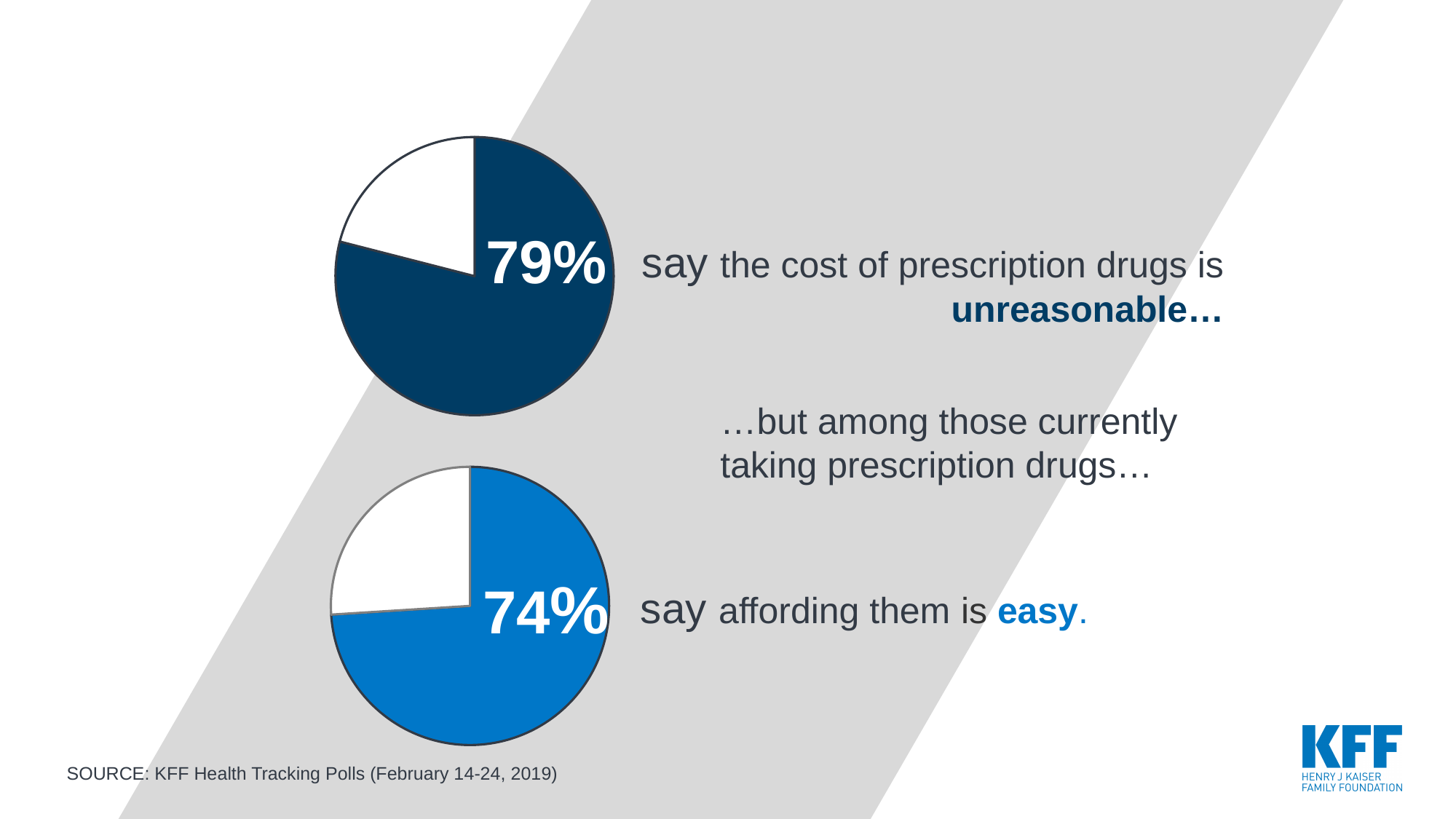
On the bottom pie chart, what share of the pie does the blue slice represent? 74% What colour is the labelled slice on the bottom pie chart? Light blue What source is cited for the data on the slide? KFF Health Tracking Polls (February 14-24, 2019) On the top pie chart, what share of the pie does the dark blue slice represent? 79% Which is larger: the labelled share on the top pie chart or the labelled share on the bottom pie chart? The top pie chart (79%) How many pie charts are shown on the slide? 2 What is the difference in percentage points between the 79% on the top pie chart and the 74% on the bottom pie chart? 5 percentage points On the top pie chart, which slice is larger: the dark blue slice or the white slice? The dark blue slice What kind of chart is used on this slide to show the 79% and 74% figures? Pie chart On the bottom pie chart, what percentage of those currently taking prescription drugs say affording them is easy? 74% How many slices does the top pie chart have? 2 On the top pie chart, what percentage say the cost of prescription drugs is unreasonable? 79%